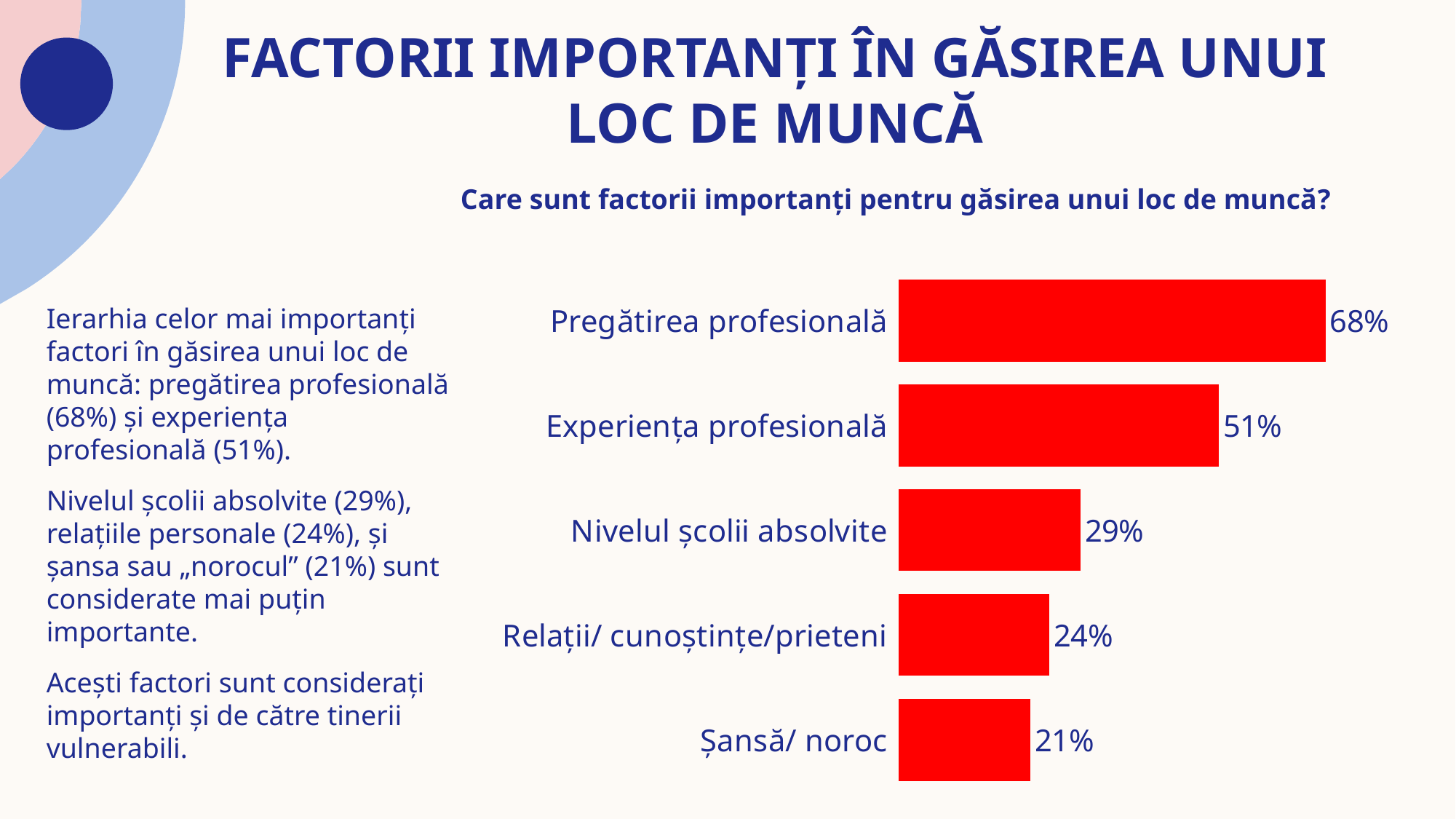
What kind of chart is shown on the slide? Bar chart What is the difference between the values for Nivelul școlii absolvite and Șansă/ noroc? 8% What is the value for Șansă/ noroc? 21% What is the value for Pregătirea profesională? 68% What is the value for Relații/ cunoștințe/prieteni? 24% Which category has the highest value? Pregătirea profesională Which is larger, the value for Experiența profesională or the value for Nivelul școlii absolvite? Experiența profesională What is the difference between the values for Pregătirea profesională and Experiența profesională? 17% How many categories are shown in the chart? 5 What is the value for Nivelul școlii absolvite? 29% Which category has the lowest value? Șansă/ noroc What is the value for Experiența profesională? 51%